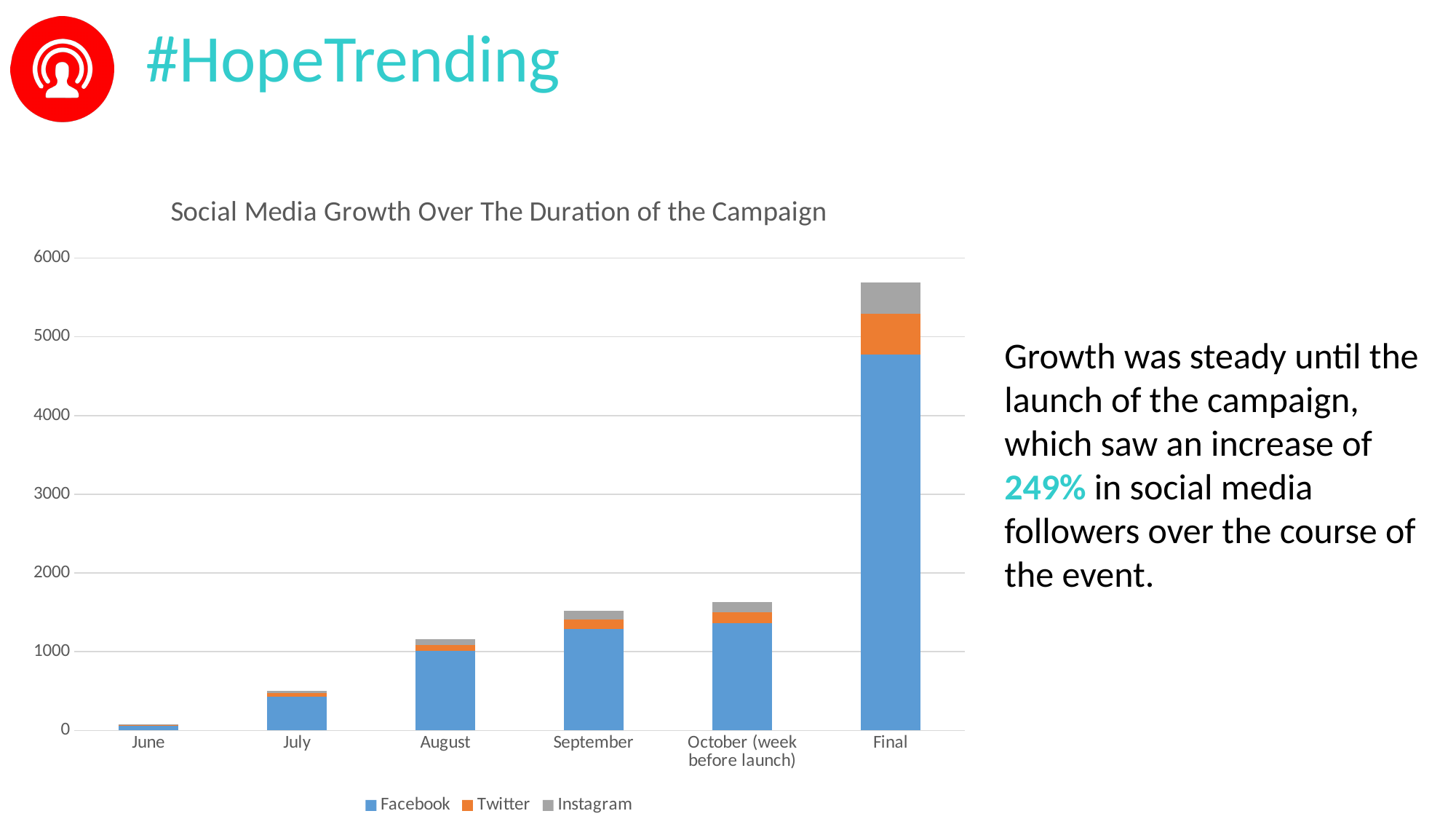
How many series does the legend list? 3 Is the Facebook value for Final greater or less than 4000? greater Is the total value for August greater or less than 1000? greater Do the total bar values rise or fall from June to Final? Rise Which category has the highest total bar? Final Which category has the lowest total bar? June Which series are listed in the legend? Facebook, Twitter, Instagram What is the title of the chart? Social Media Growth Over The Duration of the Campaign Which has a larger total bar, September or July? September Is the total value for Final greater or less than 5000? greater What type of chart is shown on the slide? Stacked bar chart How many categories are shown on the x axis? 6